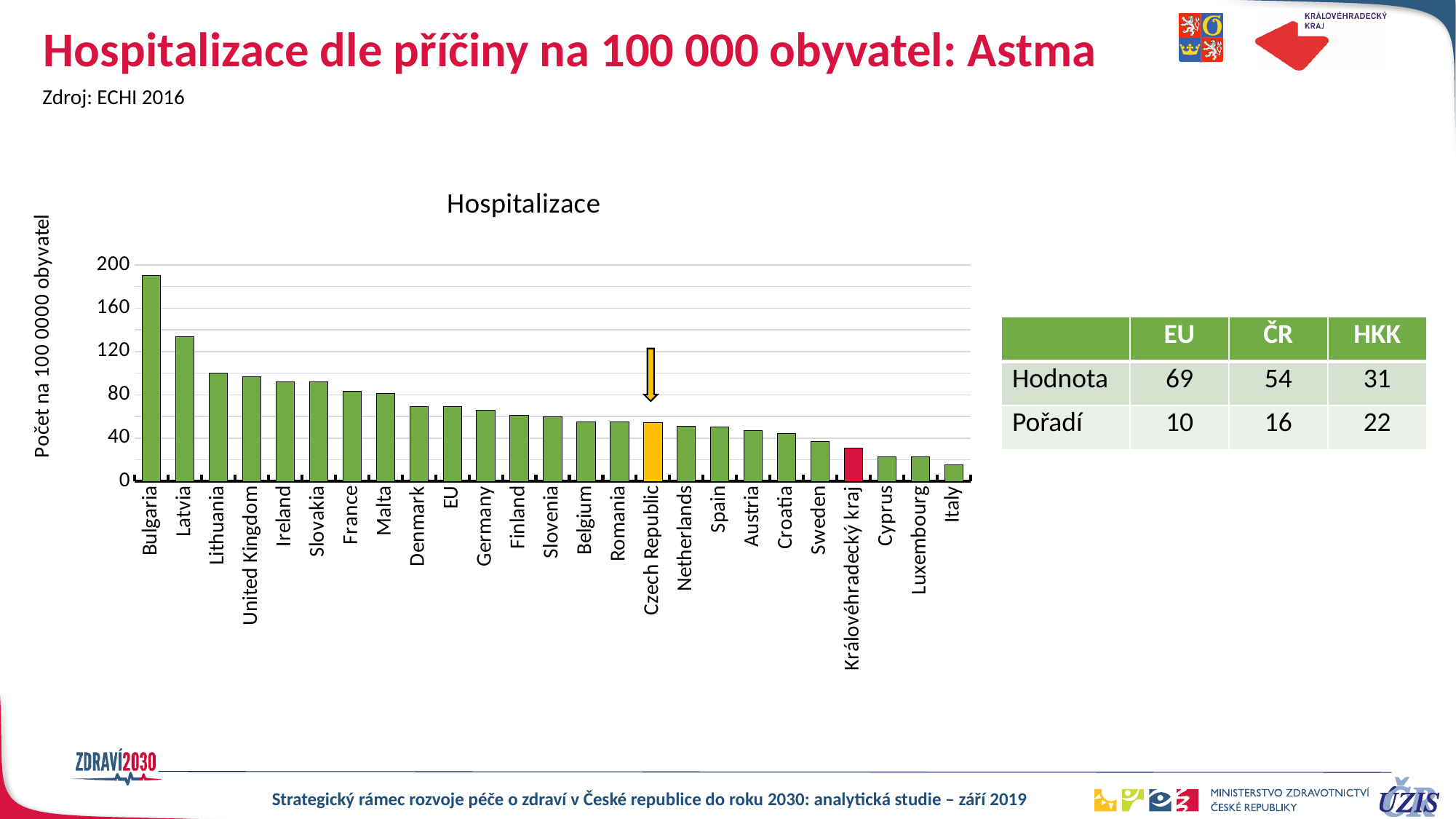
Is the value for Latvia greater or less than 120? greater What kind of chart is shown on the slide? bar chart Which category has the lowest value in the chart? Italy According to the table, what is the difference between the value for ČR and the value for HKK? 23 Is the value for Italy greater or less than 40? less Which category has the highest value in the chart? Bulgaria How many bars (categories) are plotted in the chart? 25 Is the value for Bulgaria greater or less than 160? greater Which is larger, the value for Bulgaria or the value for Latvia? Bulgaria Do the values rise or fall from left to right along the x axis? fall What is the title of the chart? Hospitalizace According to the table, what is the value (Hodnota) for the EU? 69